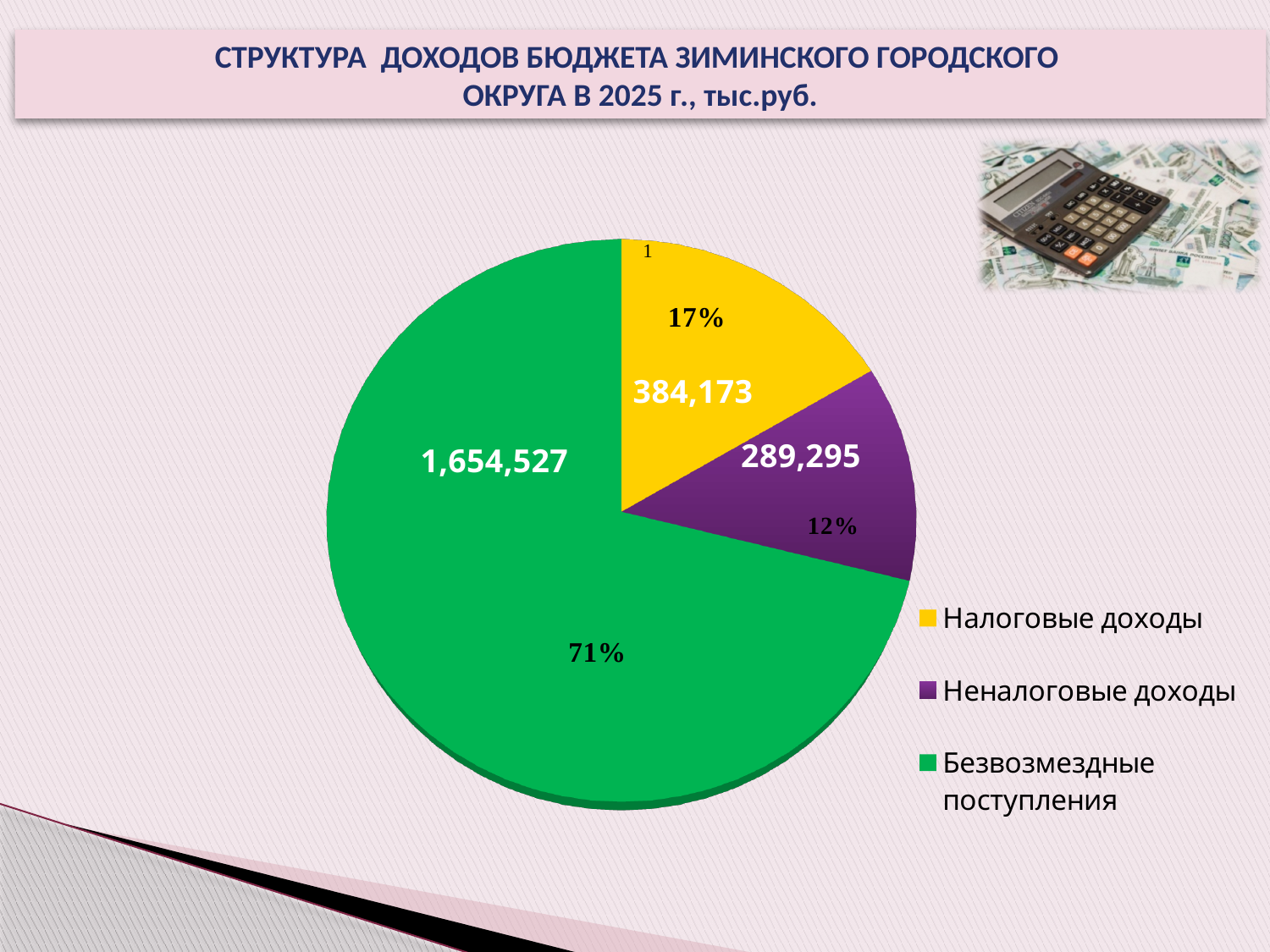
Which category has the smallest slice? Неналоговые доходы What is the difference between Налоговые доходы and Неналоговые доходы? 94,878 What is the value for Неналоговые доходы? 289,295 What share of the pie does Неналоговые доходы take? 12% What is the value for Налоговые доходы? 384,173 How many categories does the legend list? 3 Which is larger, Налоговые доходы or Неналоговые доходы? Налоговые доходы What share of the pie does Безвозмездные поступления take? 71% Which category has the largest slice? Безвозмездные поступления What type of chart is shown on the slide? pie chart What share of the pie does Налоговые доходы take? 17% What is the value for Безвозмездные поступления? 1,654,527